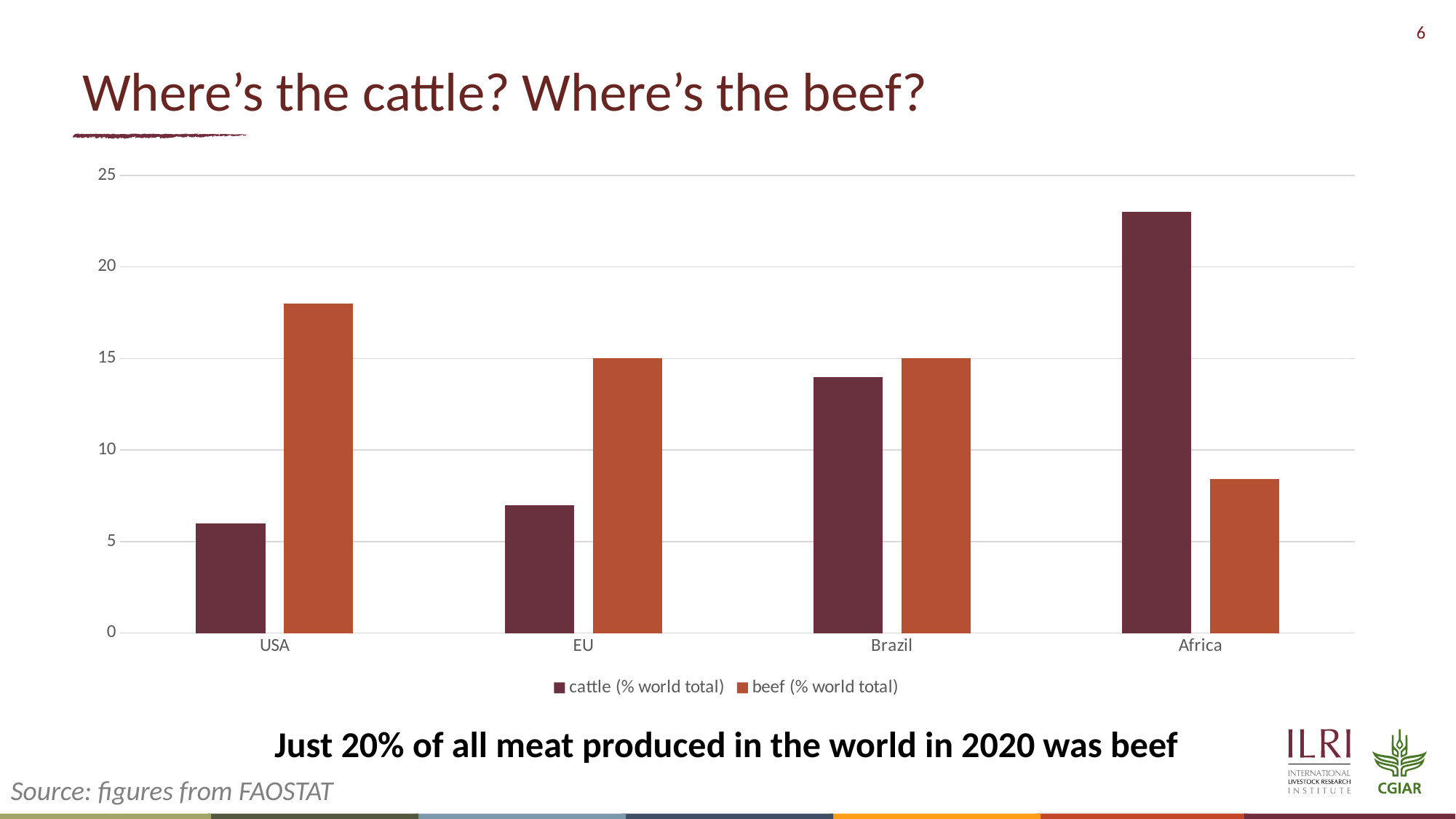
What kind of chart is shown on the slide? bar chart Which category has the highest value for beef (% world total)? USA Is the value for cattle (% world total) in Africa greater or less than 20? greater How many categories are shown on the x axis? 4 For the USA, which is larger: cattle (% world total) or beef (% world total)? beef (% world total) How many series does the legend list? 2 Which category has the lowest value for beef (% world total)? Africa Which category has the highest value for cattle (% world total)? Africa For Africa, which is larger: cattle (% world total) or beef (% world total)? cattle (% world total) What are the two series named in the legend? cattle (% world total) and beef (% world total) Is the value for cattle (% world total) in the USA greater or less than 10? less Which category has the lowest value for cattle (% world total)? USA